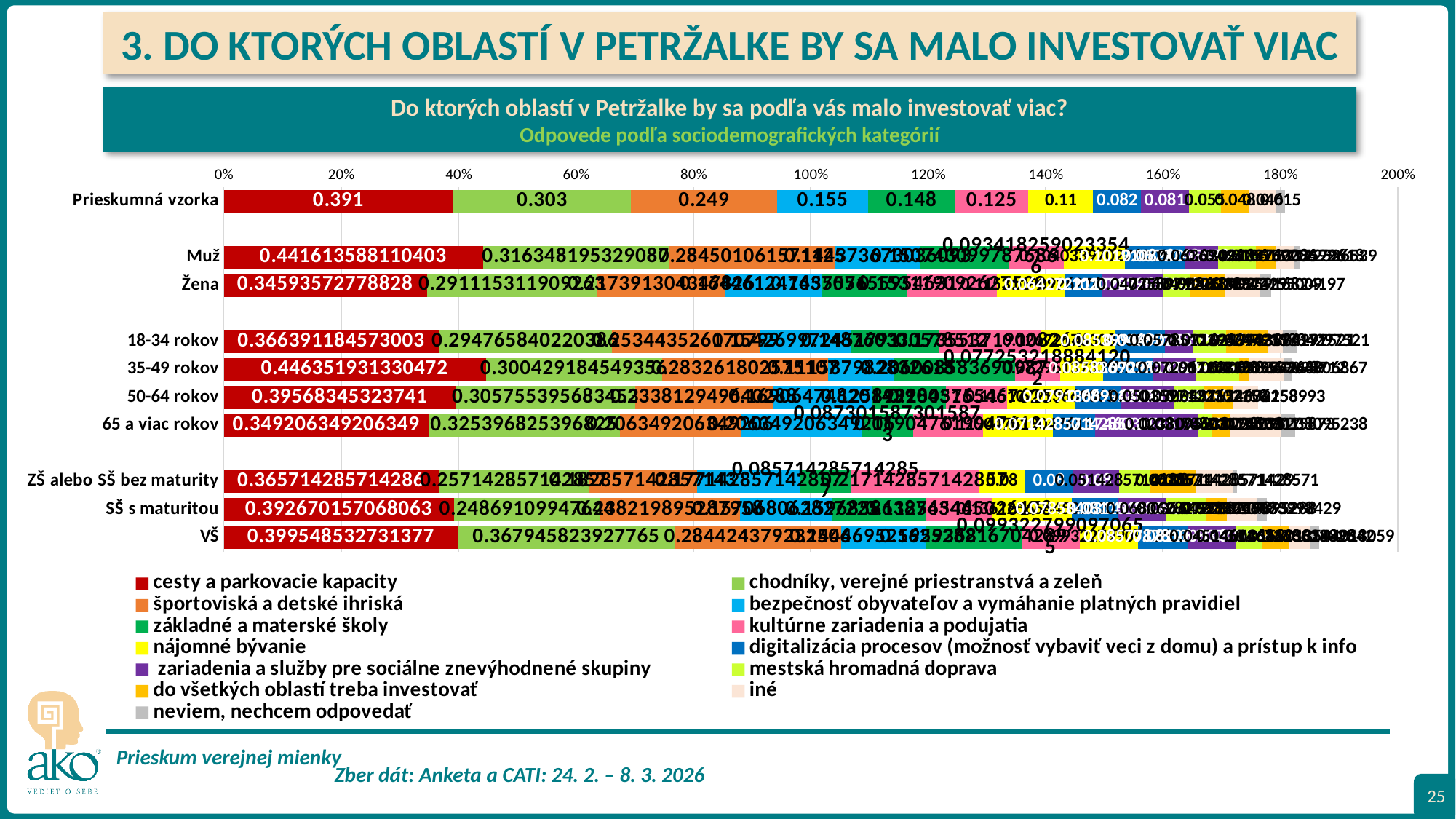
Which colour represents 'cesty a parkovacie kapacity' in the legend? dark red What is the value for 'športoviská a detské ihriská' in the 'Prieskumná vzorka' row? 0.249 What is the value for 'nájomné bývanie' in the 'Prieskumná vzorka' row? 0.11 Which age group has the highest 'cesty a parkovacie kapacity' value? 35-49 rokov What kind of chart is shown on the slide? stacked bar chart What is the difference between the 'cesty a parkovacie kapacity' and 'chodníky, verejné priestranstvá a zeleň' values in the 'Prieskumná vzorka' row? 0.088 Which row has the higher 'cesty a parkovacie kapacity' value, 'Muž' or 'Žena'? Muž What is the value for 'cesty a parkovacie kapacity' in the 'Muž' row? 0.441613588110403 How many series does the legend list? 13 How many categories (rows) are plotted on the y axis? 10 What is the value for 'chodníky, verejné priestranstvá a zeleň' in the 'Prieskumná vzorka' row? 0.303 What is the value for 'cesty a parkovacie kapacity' in the 'Prieskumná vzorka' row? 0.391